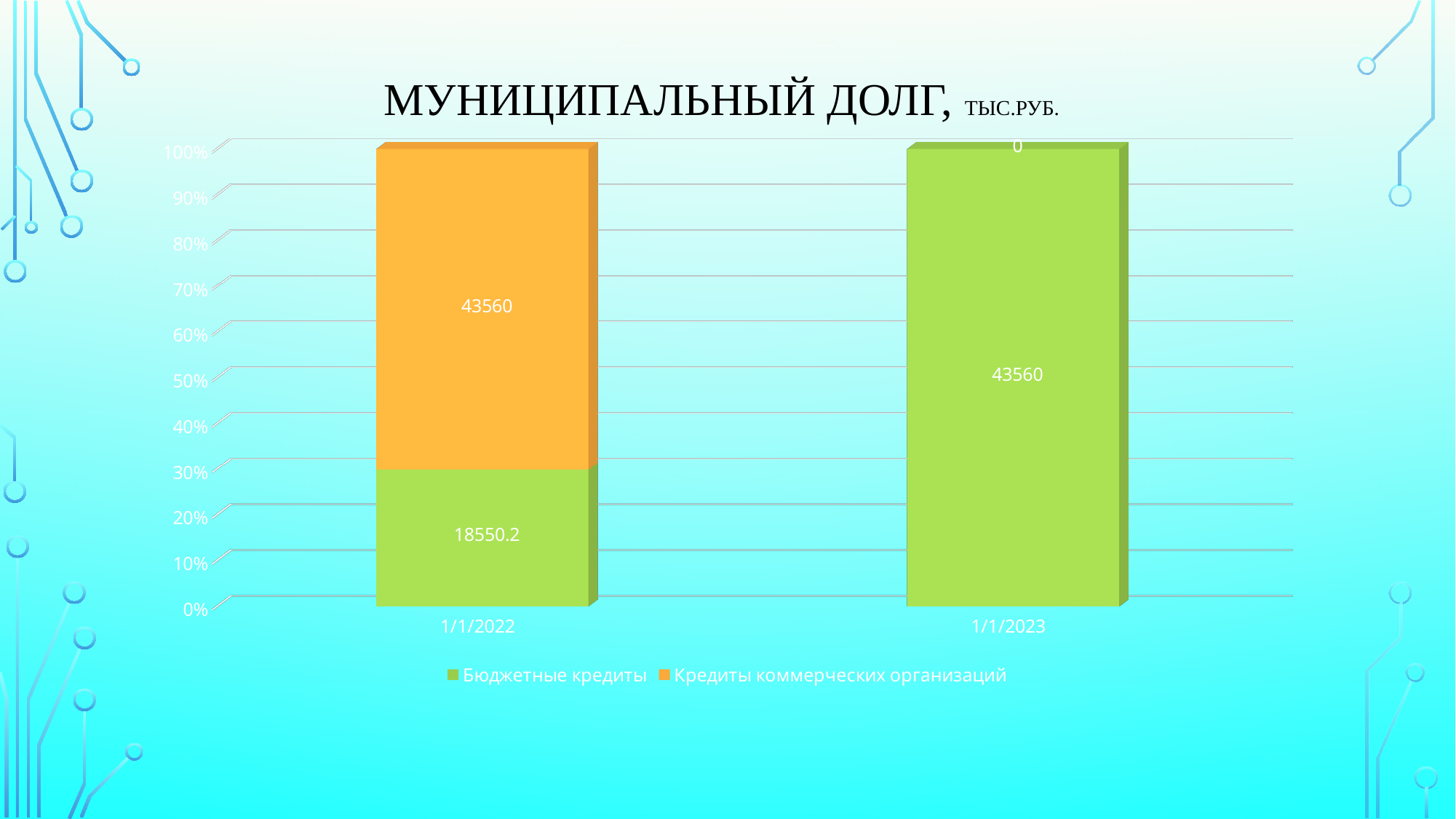
How many categories are shown on the x axis? 2 How many series does the legend list? 2 On 1/1/2022, which is larger: Бюджетные кредиты or Кредиты коммерческих организаций? Кредиты коммерческих организаций What is the title of the chart? МУНИЦИПАЛЬНЫЙ ДОЛГ, ТЫС.РУБ. What is the value for Кредиты коммерческих организаций on 1/1/2022? 43560 What is the total of the stacked bar for 1/1/2022? 62110.2 Is the share of Бюджетные кредиты in the 1/1/2022 bar greater or less than 40%? less What is the value for Бюджетные кредиты on 1/1/2022? 18550.2 What is the difference between Кредиты коммерческих организаций and Бюджетные кредиты on 1/1/2022? 25009.8 What is the value for Бюджетные кредиты on 1/1/2023? 43560 What kind of chart is shown on the slide? stacked bar chart What is the value for Кредиты коммерческих организаций on 1/1/2023? 0